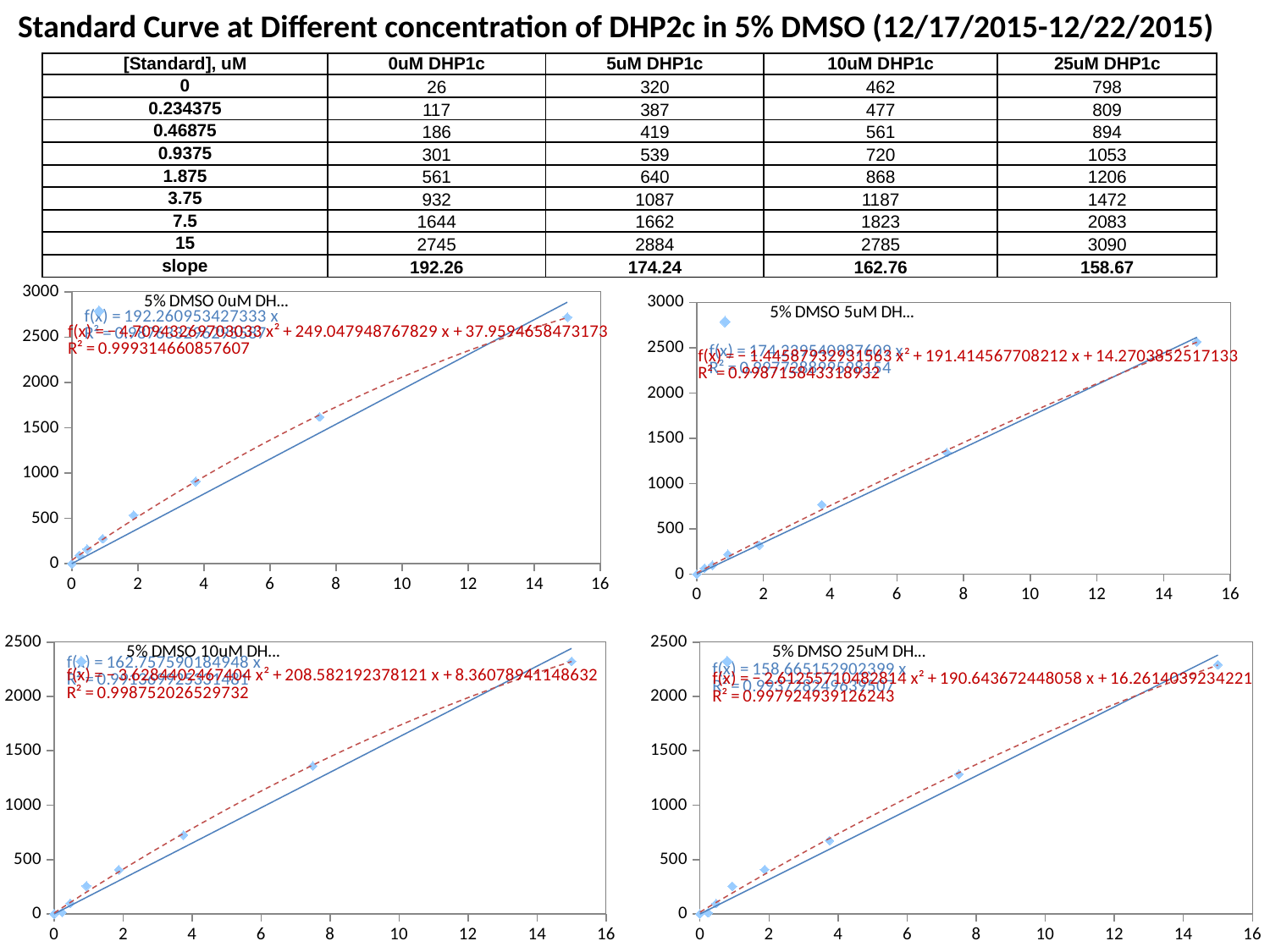
In the bottom-left chart (5% DMSO 10uM DH...), which point has the larger value: the one at x = 7.5 or the one at x = 15? x = 15 In the top-right chart (5% DMSO 5uM DH...), is the value of the point at x = 15 greater or less than 2000? greater In the bottom-left chart (5% DMSO 10uM DH...), is the value of the point at x = 7.5 greater or less than 1500? less What is the maximum value shown on the y axis of the top-left chart (5% DMSO 0uM DH...)? 3000 In the top-left chart (5% DMSO 0uM DH...), is the value of the point at x = 3.75 greater or less than 1000? less What kind of chart is the top-left chart titled "5% DMSO 0uM DH..."? scatter chart In the bottom-right chart (5% DMSO 25uM DH...), at which x value is the plotted point highest? 15 In the top-left chart (5% DMSO 0uM DH...), do the plotted values rise or fall as x increases? rise What R² value is printed in red for the quadratic fit in the bottom-left chart (5% DMSO 10uM DH...)? 0.998752026529732